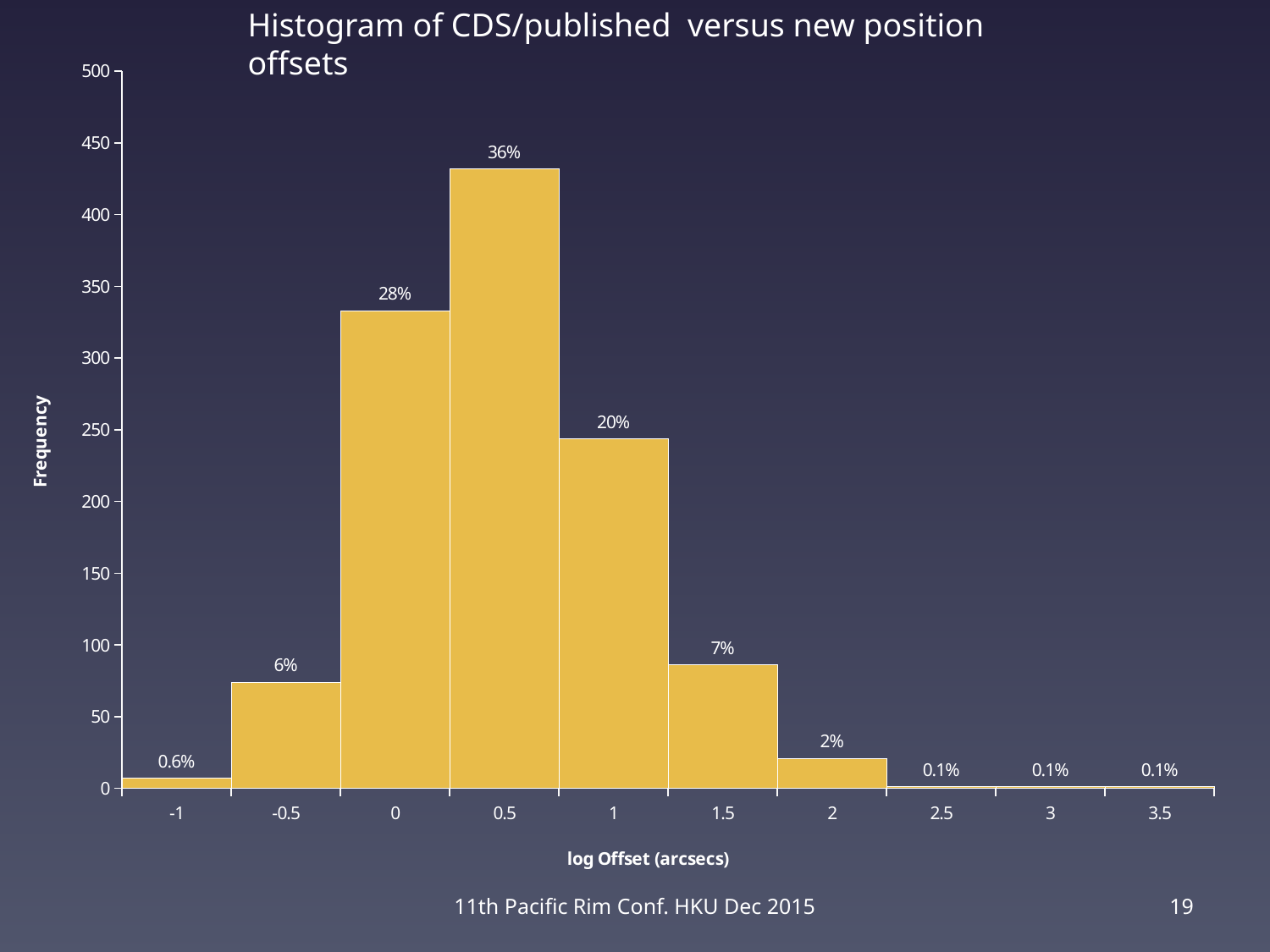
Is the frequency for the bin at log Offset 0.5 greater or less than 400? greater What percentage label is shown on the bar at log Offset -1? 0.6% What percentage label is shown on the bar at log Offset 0? 28% What percentage label is shown on the bar at log Offset 0.5? 36% Is the frequency for the bin at log Offset 1.5 greater or less than 100? less What kind of chart is shown on the slide? bar chart (histogram) What is the label of the x axis? log Offset (arcsecs) Which bin has a higher frequency, log Offset 0 or log Offset 1? 0 What percentage label is shown on the bar at log Offset 1.5? 7% What is the difference between the percentage labels for the bins at log Offset 0.5 and 0? 8% How many bins are shown along the x axis? 10 Which log Offset bin has the highest frequency? 0.5